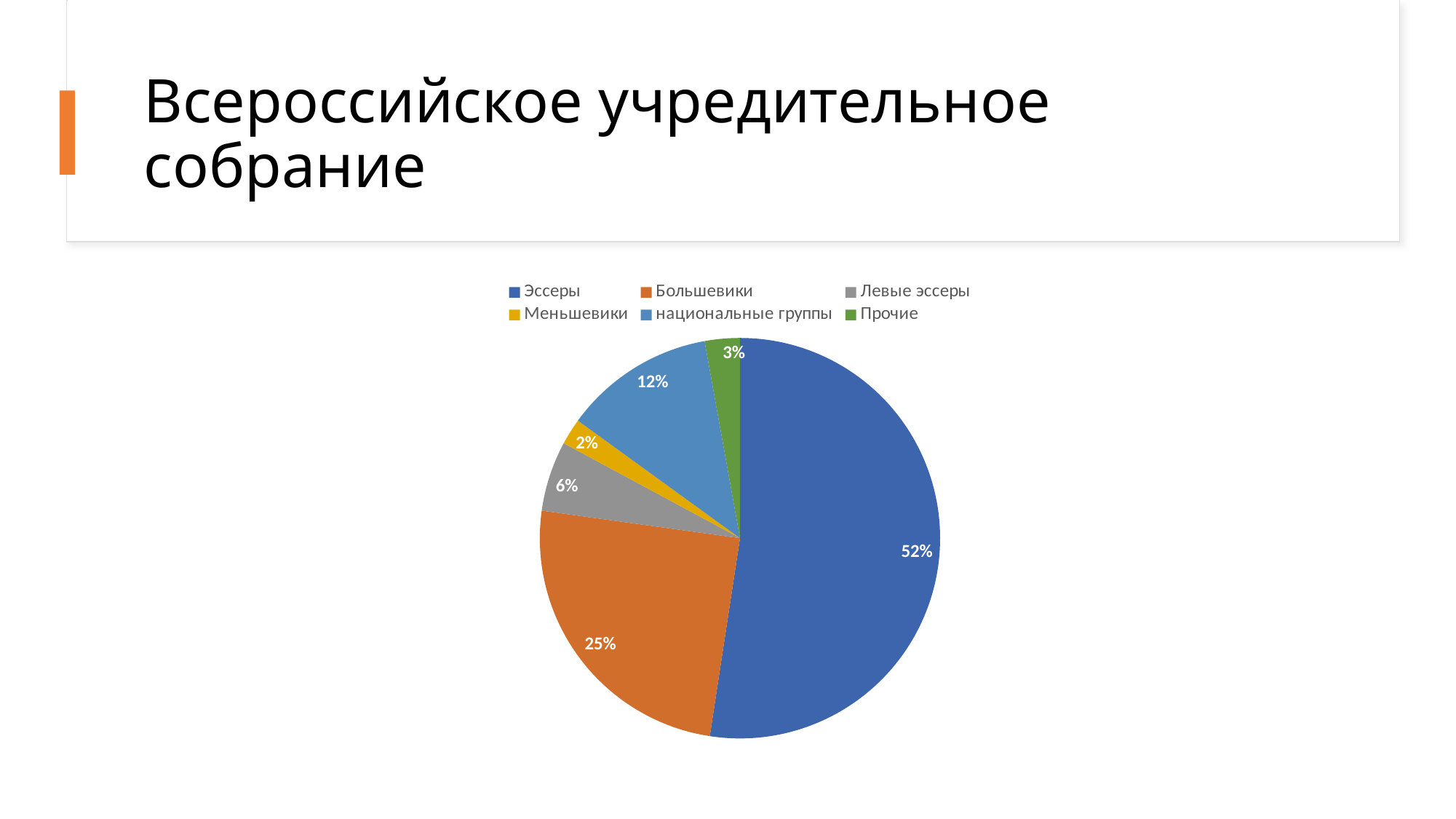
What is the difference in percentage points between the Эссеры and Большевики slices? 27 Which category has the smallest slice of the pie? Меньшевики What share of the pie does национальные группы hold? 12% What share of the pie does Меньшевики hold? 2% What share of the pie does Левые эссеры hold? 6% What kind of chart is shown on the slide? pie chart Which slice is larger, национальные группы or Левые эссеры? национальные группы Which category has the largest slice of the pie? Эссеры How many categories does the pie chart show? 6